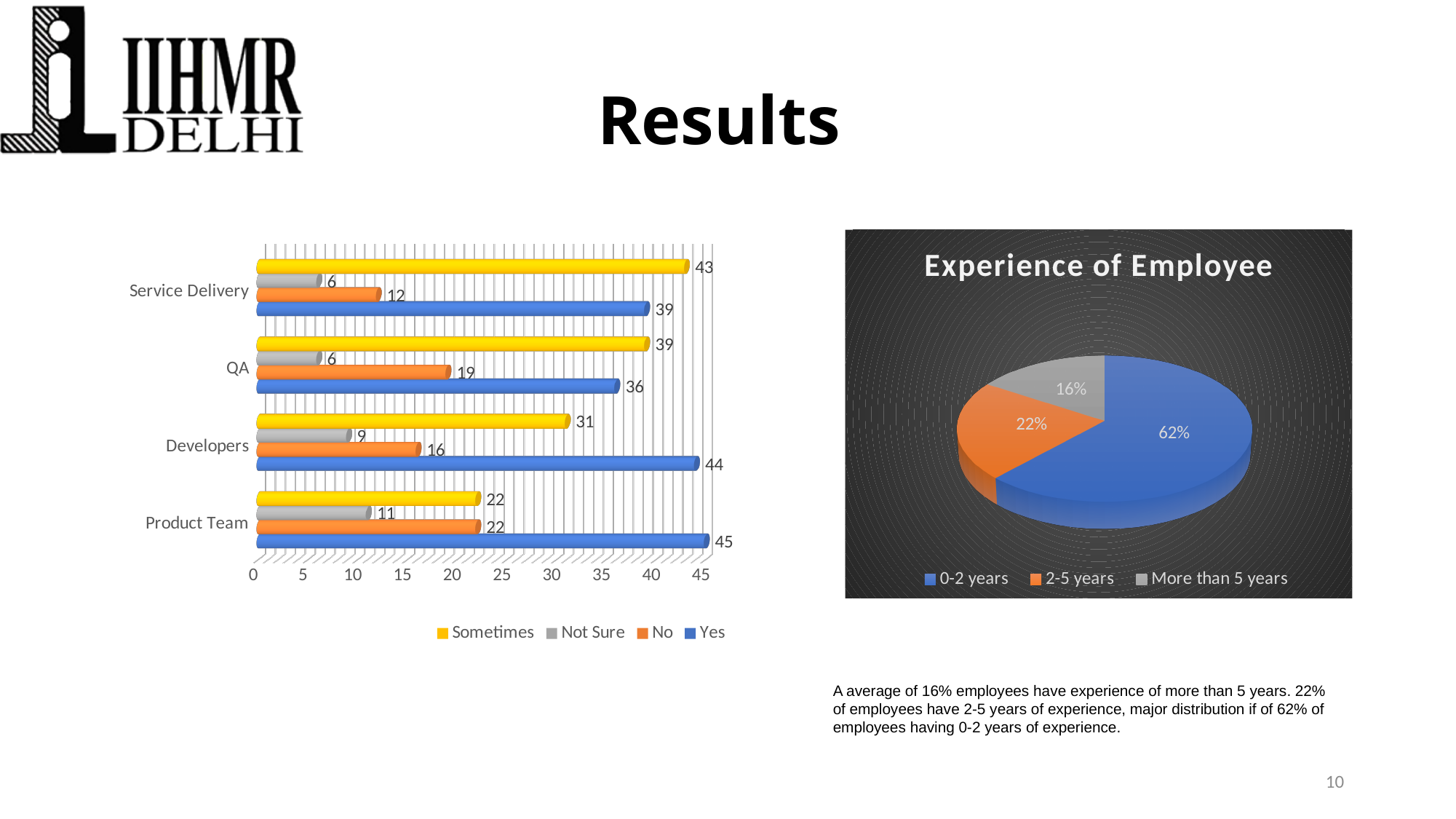
In the bar chart on the left, which category has the lowest 'Sometimes' value? Product Team In the 'Experience of Employee' chart, what share of employees have 2-5 years of experience? 22% In the bar chart on the left, what is the 'No' value for QA? 19 How many categories are shown in the bar chart on the left? 4 In the bar chart on the left, is the 'No' value for Developers larger or smaller than the 'No' value for Service Delivery? larger In the bar chart on the left, what is the difference between the 'Yes' values for Developers and QA? 8 In the bar chart on the left, what is the 'Sometimes' value for Service Delivery? 43 In the 'Experience of Employee' chart, which slice is the largest? 0-2 years What kind of chart is the 'Experience of Employee' chart? pie chart In the bar chart on the left, which category has the highest 'Not Sure' value? Product Team How many series does the legend of the bar chart on the left list? 4 In the bar chart on the left, what is the 'Yes' value for Product Team? 45